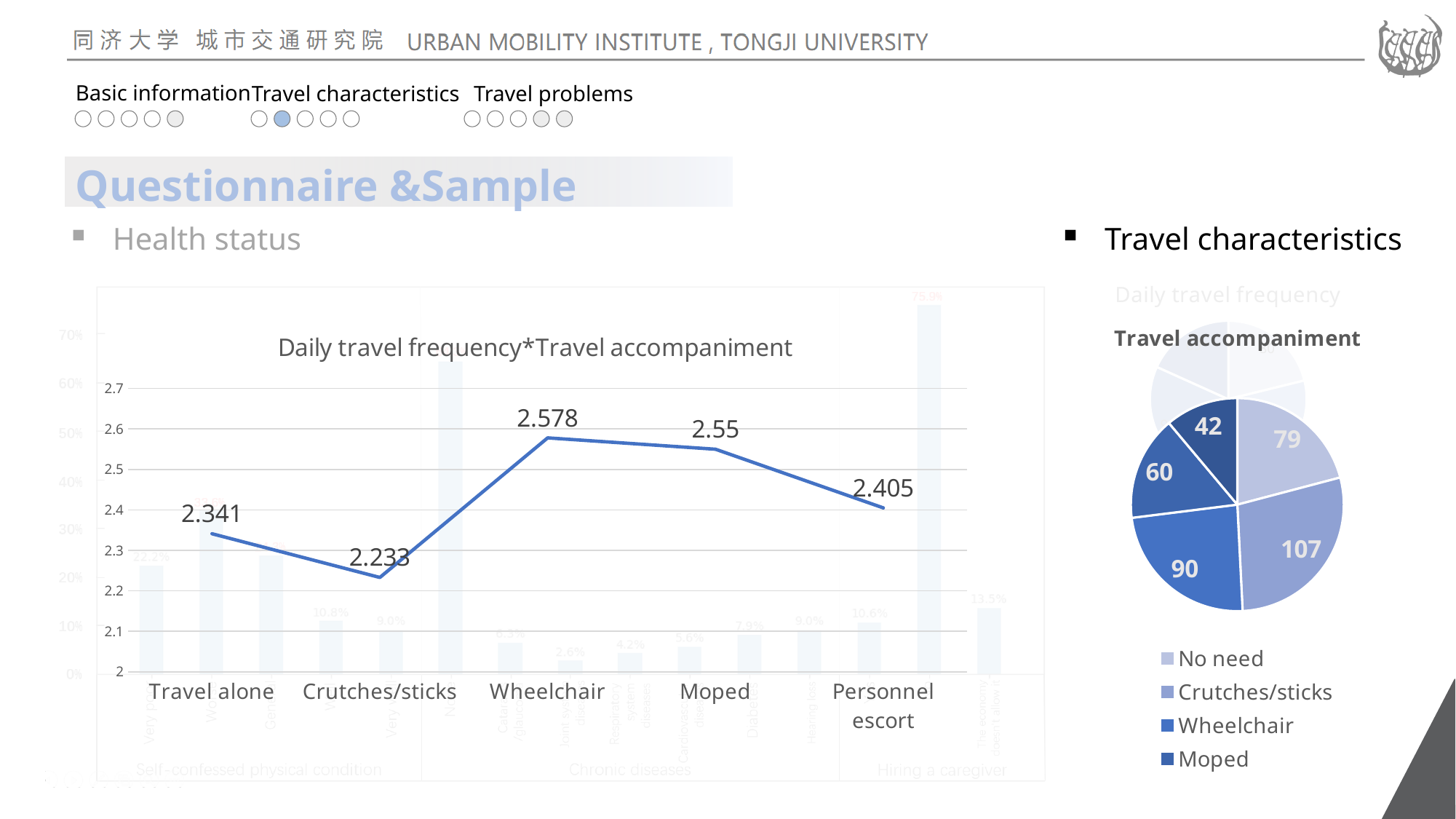
In the 'Travel accompaniment' pie chart, which is larger, the Wheelchair slice or the Moped slice? Wheelchair In the 'Travel accompaniment' pie chart, what is the difference between the No need slice and the Moped slice? 19 In the 'Daily travel frequency*Travel accompaniment' chart, what is the difference between the values for Wheelchair and Crutches/sticks? 0.345 In the 'Daily travel frequency*Travel accompaniment' chart, what is the value for Personnel escort? 2.405 In the 'Travel accompaniment' pie chart, what is the value of the Crutches/sticks slice? 107 In the 'Daily travel frequency*Travel accompaniment' chart, what is the value for Travel alone? 2.341 In the 'Daily travel frequency*Travel accompaniment' chart, which category has the highest value? Wheelchair In the 'Daily travel frequency*Travel accompaniment' chart, what is the value for Wheelchair? 2.578 In the 'Daily travel frequency*Travel accompaniment' chart, how many categories are shown on the x axis? 5 In the 'Daily travel frequency*Travel accompaniment' chart, is the value for Moped greater or less than 2.5? greater What kind of chart is the 'Daily travel frequency*Travel accompaniment' chart? line chart In the 'Daily travel frequency*Travel accompaniment' chart, which category has the lowest value? Crutches/sticks